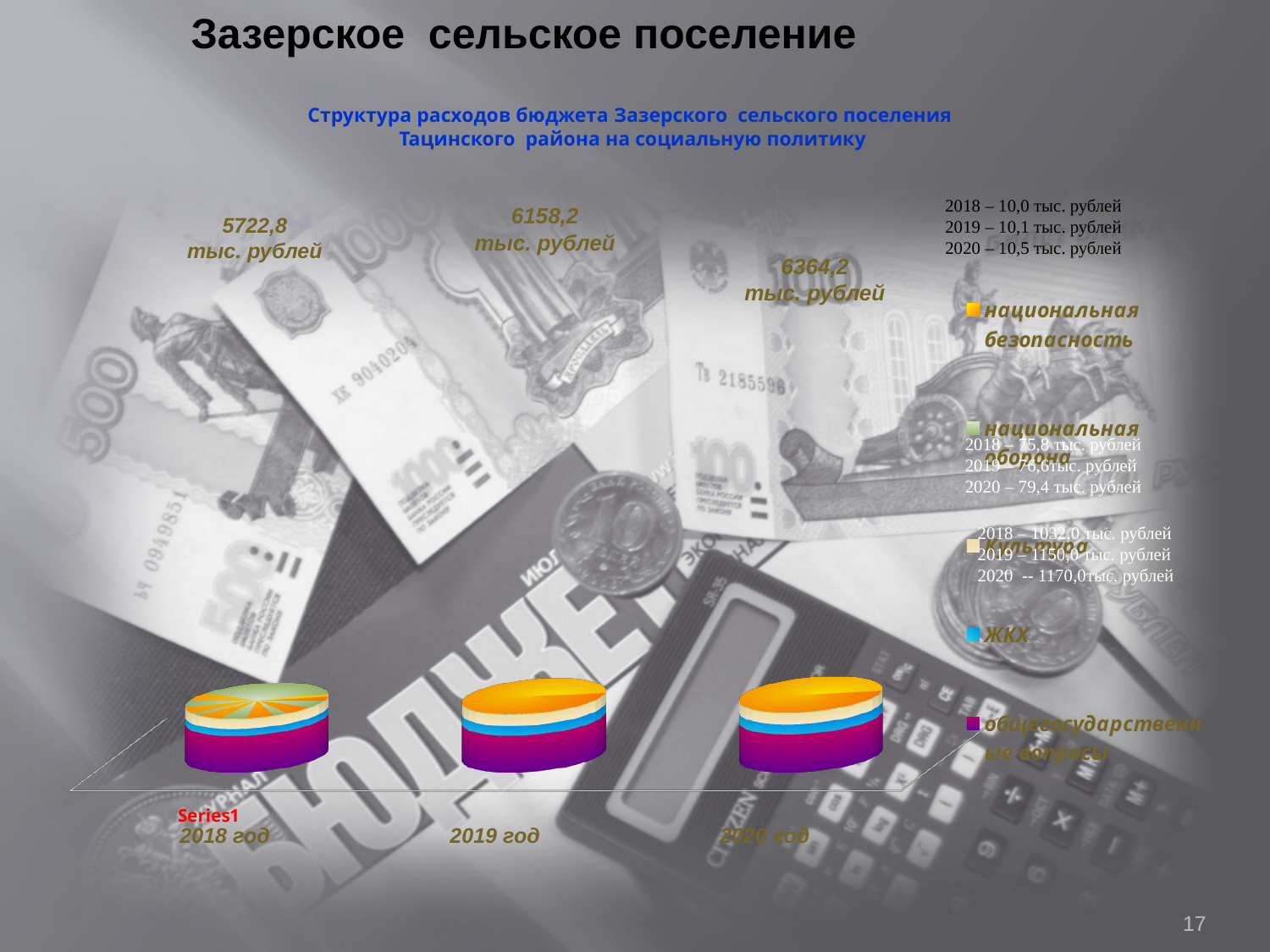
What kind of chart is shown on the slide? Stacked bar chart How many series does the chart legend list? 5 Do the total values rise or fall from 2018 год to 2020 год? Rise What is the total value shown above the bar for 2020 год? 6364,2 тыс. рублей What is the total value shown above the bar for 2019 год? 6158,2 тыс. рублей Which legend entry is shown with a light blue colour? ЖКХ Which year has the highest total value shown on the chart? 2020 год What is the total value shown above the bar for 2018 год? 5722,8 тыс. рублей Which year has the lowest total value shown on the chart? 2018 год How many categories (years) are shown on the x axis of the chart? 3 What is the difference between the total values for 2020 год and 2019 год? 206,0 тыс. рублей Which legend entry is shown with a purple colour? общегосударственные вопросы